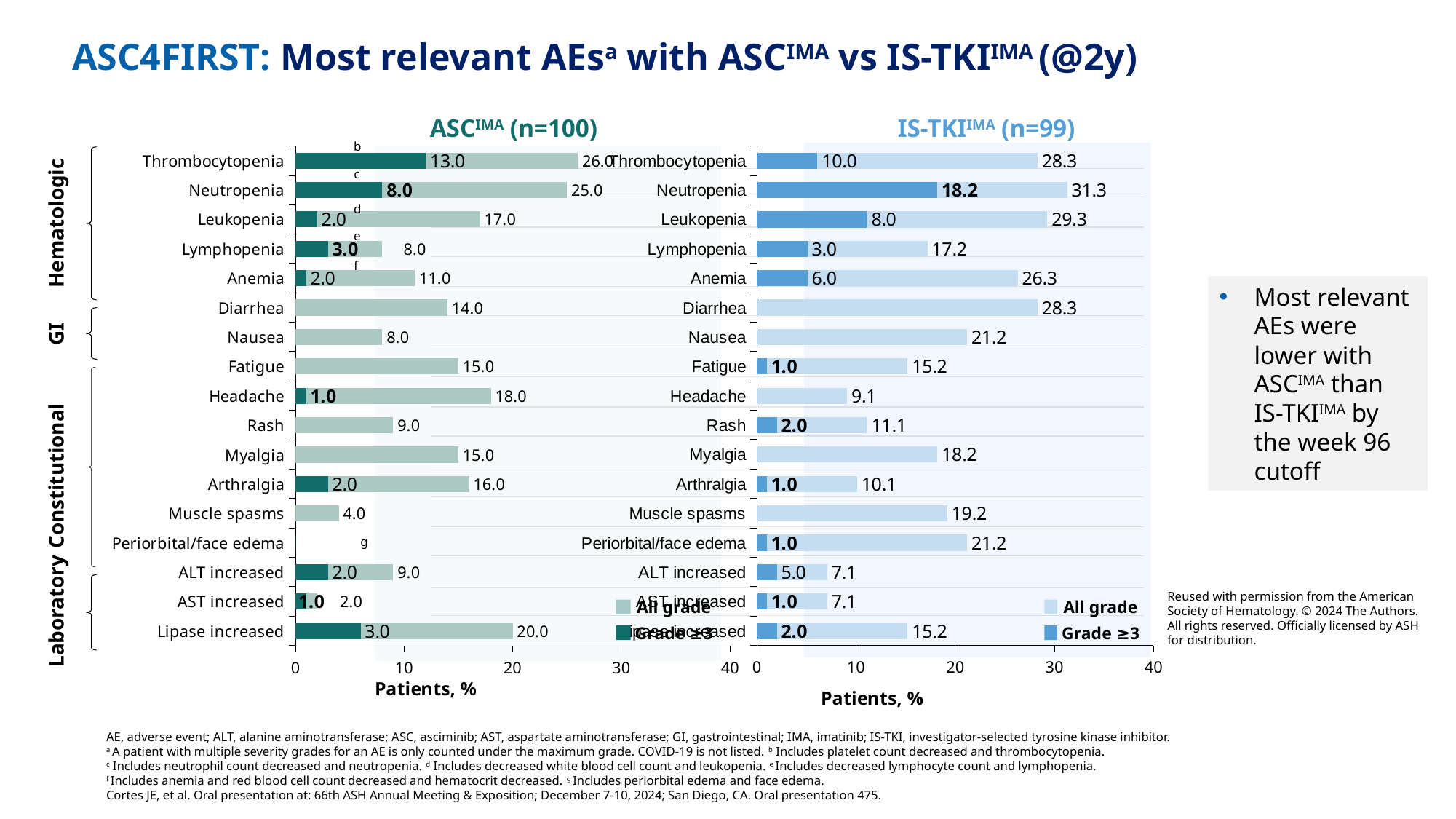
In the ASC (n=100) chart, what is the all-grade value for Thrombocytopenia? 26.0 What type of chart is the IS-TKI (n=99) chart? Bar chart Which is larger: the all-grade Neutropenia value in the ASC (n=100) chart or in the IS-TKI (n=99) chart? IS-TKI (n=99) What is the difference between the all-grade Diarrhea value in the IS-TKI (n=99) chart and the all-grade Diarrhea value in the ASC (n=100) chart? 14.3 How many adverse event categories are listed in the IS-TKI (n=99) chart? 17 In the ASC (n=100) chart, what is the Grade ≥3 value for Lipase increased? 3.0 In the ASC (n=100) chart, is the all-grade value for Headache greater or less than 10? greater In the ASC (n=100) chart, which adverse event has the highest all-grade value? Thrombocytopenia In the IS-TKI (n=99) chart, which adverse event has the highest all-grade value? Neutropenia How many series does the legend of the ASC (n=100) chart list? 2 In the IS-TKI (n=99) chart, what is the Grade ≥3 value for Neutropenia? 18.2 In the IS-TKI (n=99) chart, what is the all-grade value for Diarrhea? 28.3